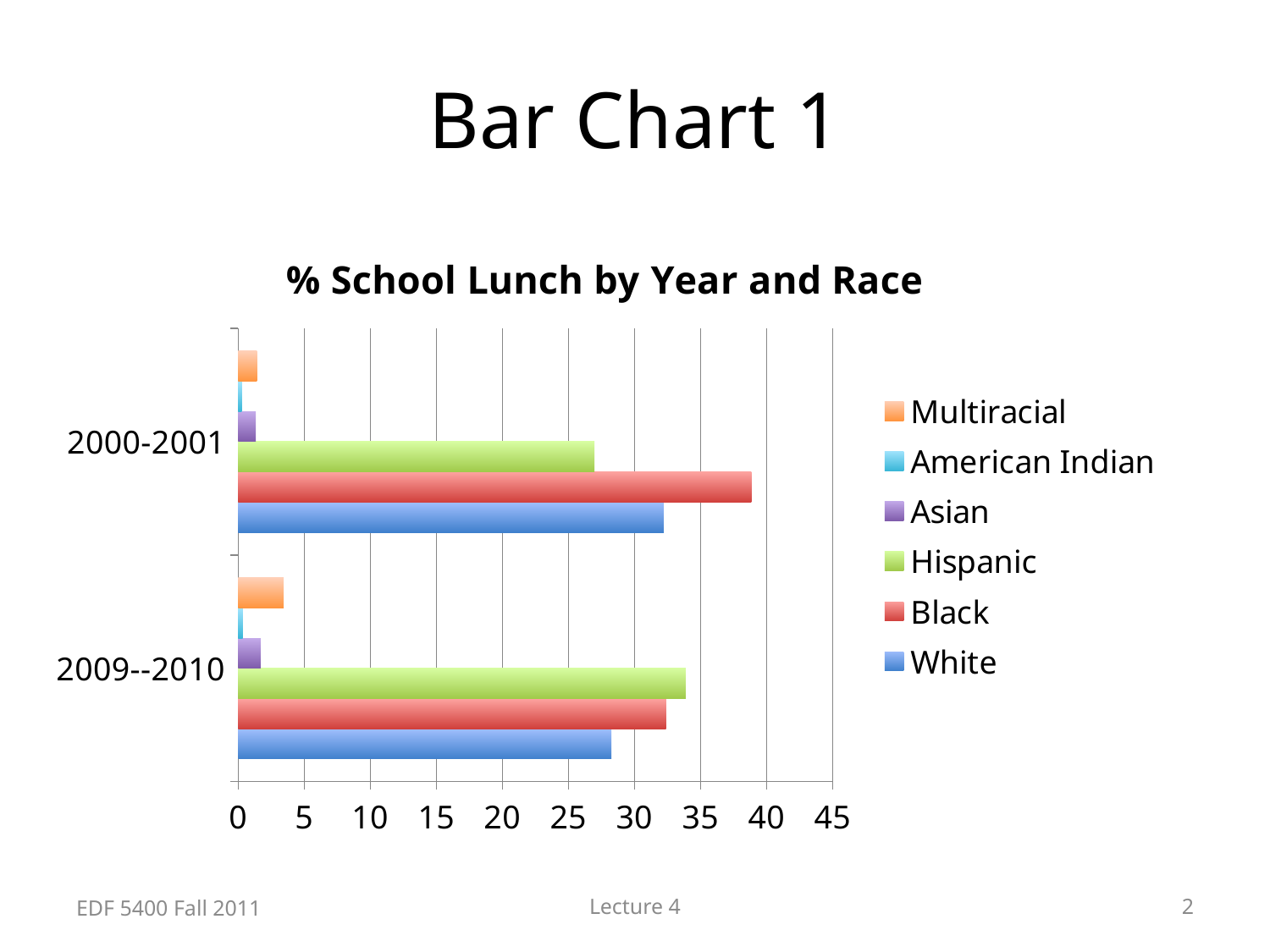
Is the value for Hispanic in 2000-2001 greater or less than 25? greater Is the value for White in 2009--2010 greater or less than 30? less What is the title of the chart? % School Lunch by Year and Race Which race has the highest value for 2009--2010? Hispanic Is the value for Black in 2000-2001 greater or less than 35? greater Which is larger, the Black value for 2000-2001 or the Black value for 2009--2010? 2000-2001 Which series is shown in green in the legend? Hispanic Which race has the highest value for 2000-2001? Black What kind of chart is shown on the slide? Bar chart How many year categories are shown on the vertical axis? 2 How many series does the legend list? 6 Which is larger, the Hispanic value for 2009--2010 or the White value for 2009--2010? Hispanic